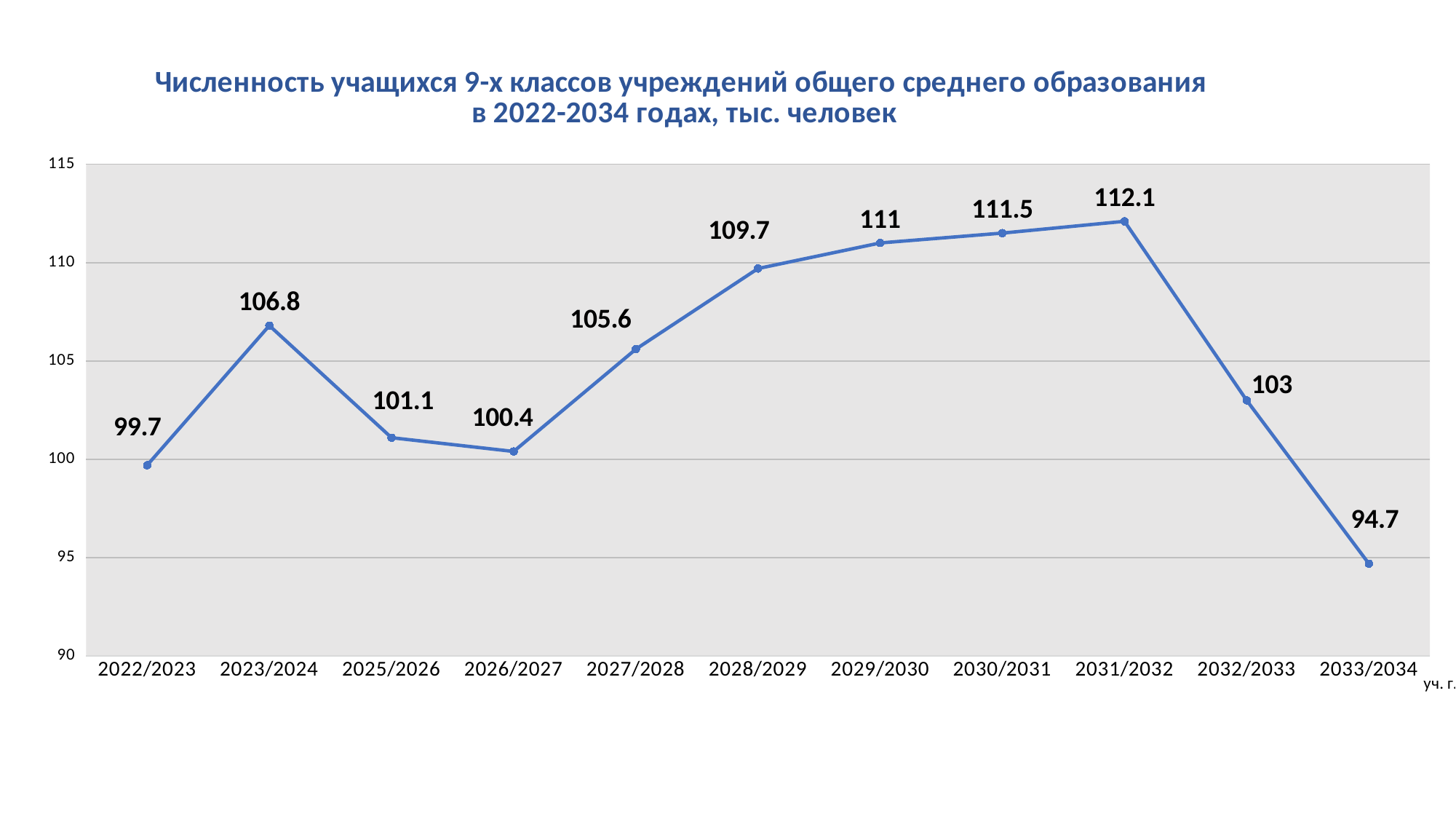
Which academic year has the lowest value? 2033/2034 What is the difference between the values for 2023/2024 and 2022/2023? 7.1 What is the value for 2023/2024? 106.8 What is the difference between the values for 2031/2032 and 2033/2034? 17.4 Which academic year has the highest value? 2031/2032 Which is larger, the value for 2025/2026 or the value for 2032/2033? 2032/2033 Is the value for 2029/2030 greater or less than 110? greater What kind of chart is shown on the slide? line chart What is the value for 2033/2034? 94.7 Do the values rise or fall from 2026/2027 to 2031/2032? rise What is the value for 2028/2029? 109.7 How many data points are plotted on the chart? 11